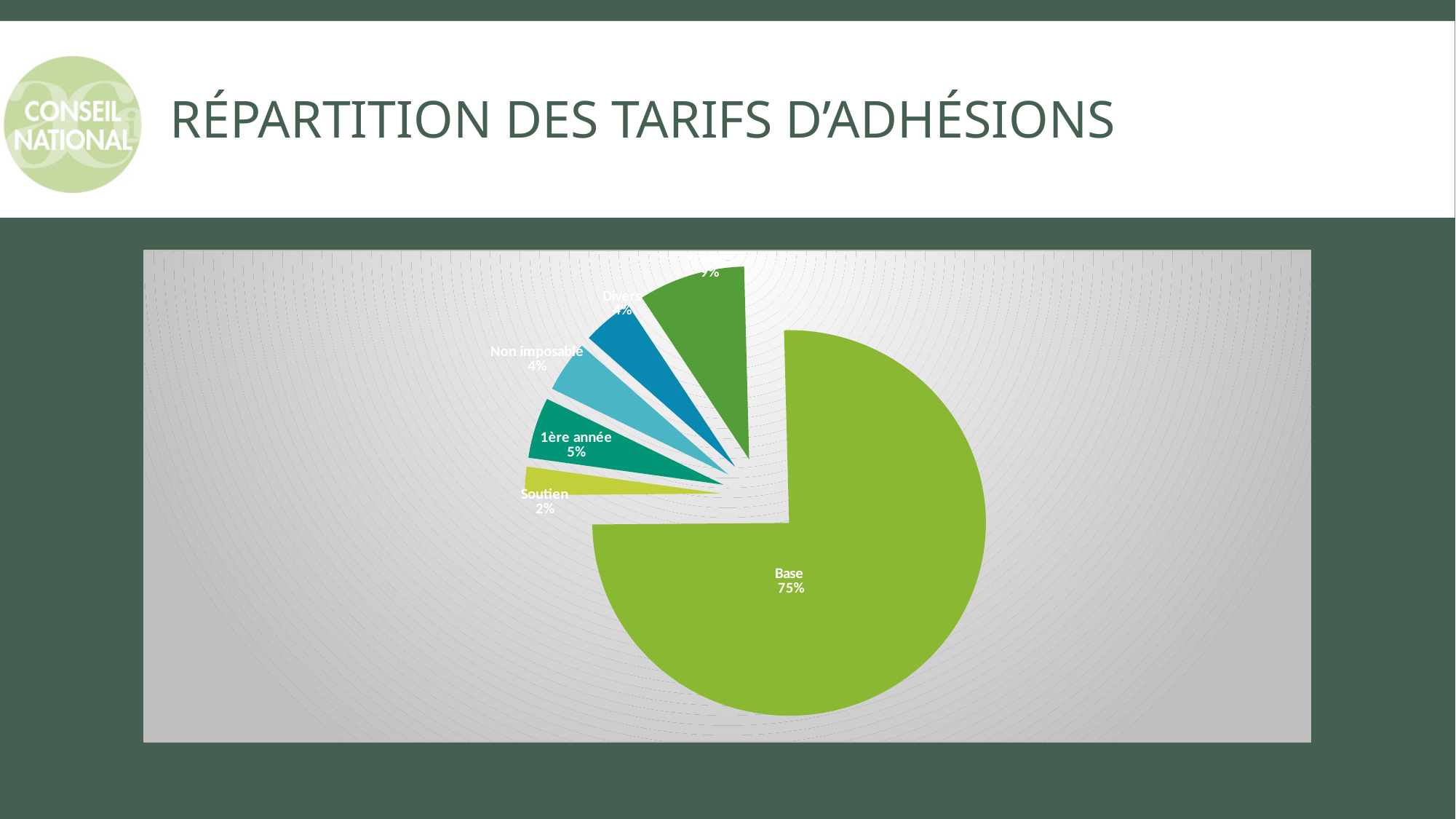
What is the difference in percentage points between the Base slice and the 1ère année slice? 70 What percentage is shown for the Divers slice? 4% What share of the pie does the Base slice represent? 75% What kind of chart is shown on the slide? pie chart What is the title of the slide containing the pie chart? RÉPARTITION DES TARIFS D'ADHÉSIONS What percentage is shown for the Soutien slice? 2% What percentage is shown for the Non imposable slice? 4% Which slice of the pie is the largest? Base How many slices does the pie chart have? 6 Which is larger, the 1ère année slice or the Soutien slice? 1ère année What percentage is shown for the 1ère année slice? 5% Which labelled slice of the pie is the smallest? Soutien